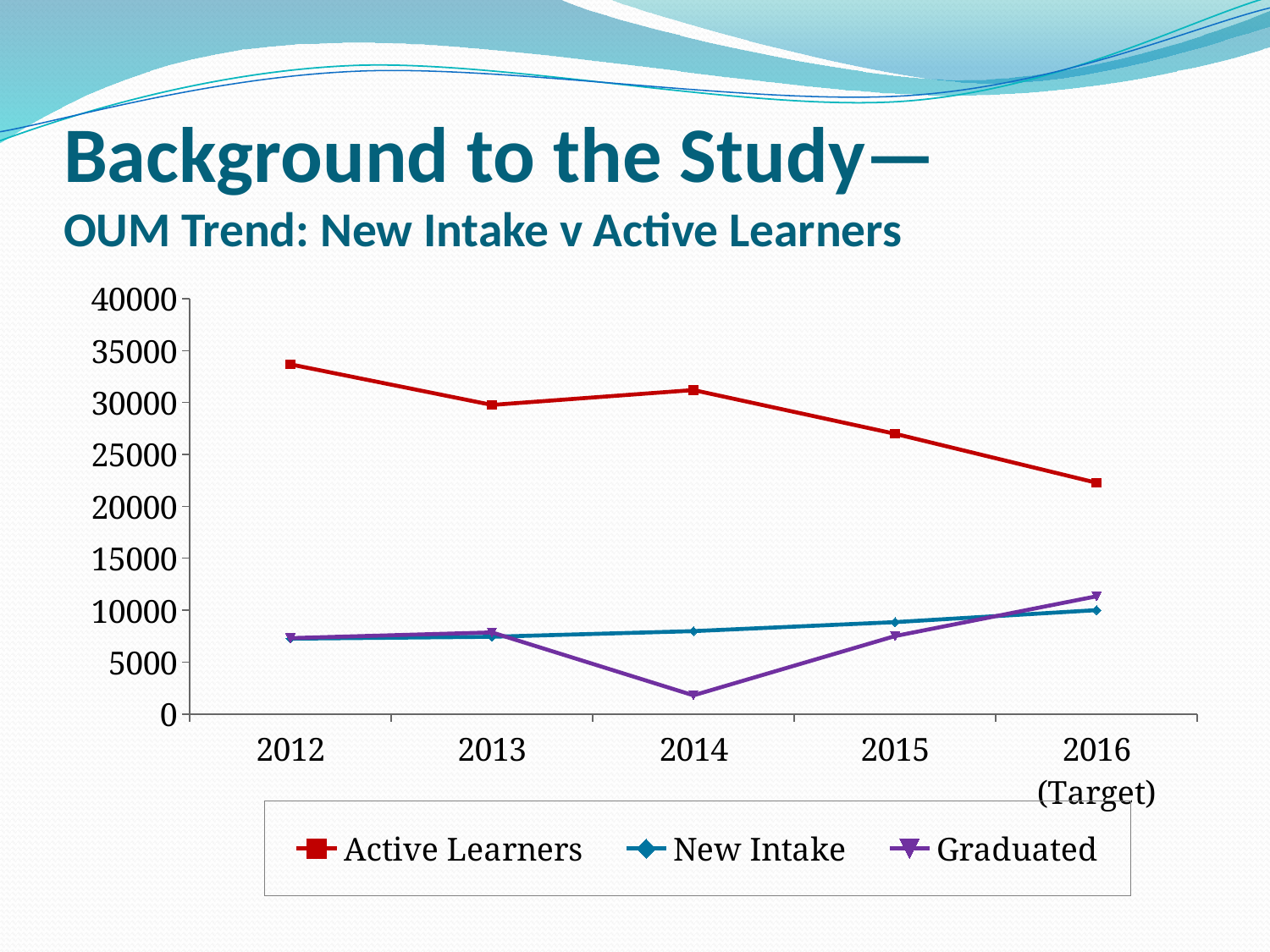
Is the Active Learners value for 2012 greater or less than 30000? greater How many series does the legend list? 3 Is the Graduated value for 2014 greater or less than 5000? less In which year is the Graduated value lowest? 2014 Does the Active Learners line rise or fall overall from 2012 to 2016 (Target)? fall Which series is drawn in red? Active Learners Does the New Intake line rise or fall from 2012 to 2016 (Target)? rise In which year is the Active Learners value highest? 2012 Is the Active Learners value for 2016 (Target) greater or less than 25000? less How many years are shown along the x axis? 5 In 2014, which is larger: New Intake or Graduated? New Intake What kind of chart is shown on the slide? line chart